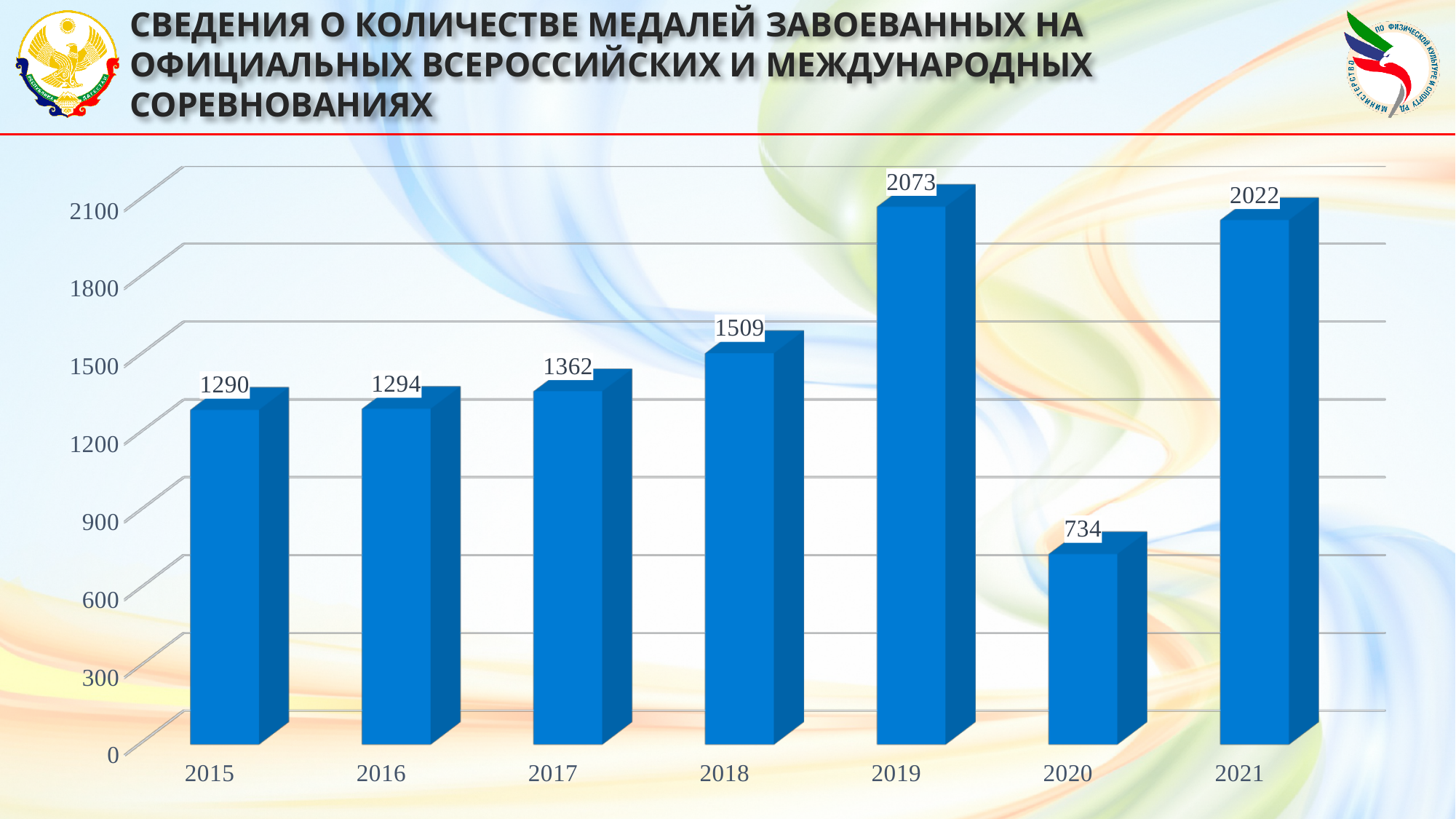
How many medals were won in 2019? 2073 Which is larger, the value for 2021 or the value for 2018? 2021 Is the value for 2018 greater or less than 1500? greater What is the difference between the values for 2018 and 2017? 147 What is the value shown for 2017? 1362 Did the number of medals rise or fall from 2015 to 2019? rise Which year has the highest number of medals? 2019 Which year has the lowest number of medals? 2020 What is the difference between the values for 2019 and 2020? 1339 What kind of chart is shown on the slide? bar chart How many years are shown on the x axis? 7 What is the value shown for 2020? 734